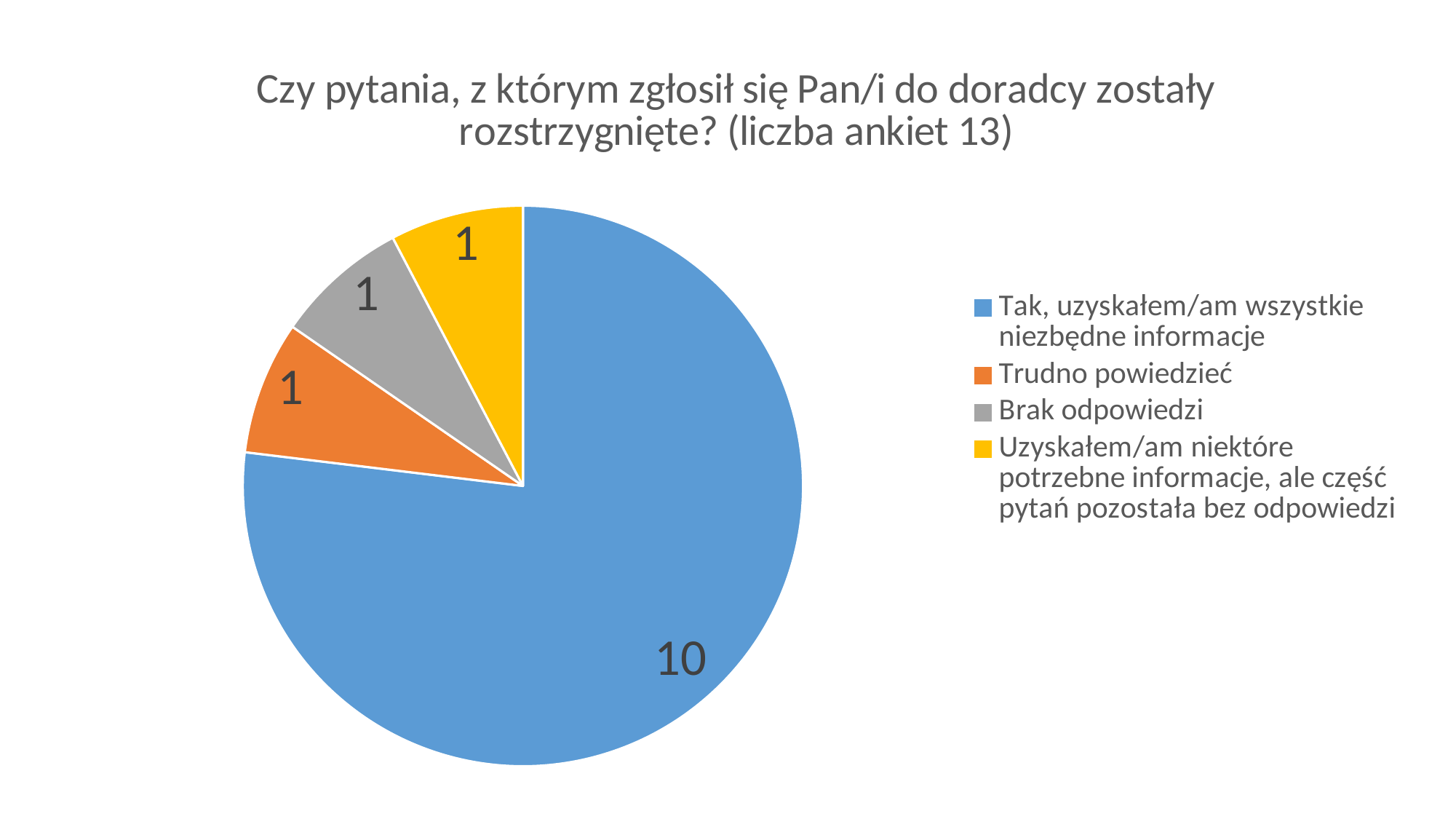
What type of chart is shown on the slide? Pie chart What is the value for "Trudno powiedzieć"? 1 What is the value for "Tak, uzyskałem/am wszystkie niezbędne informacje"? 10 What is the difference between the value for "Tak, uzyskałem/am wszystkie niezbędne informacje" and the value for "Brak odpowiedzi"? 9 What is the value for "Uzyskałem/am niektóre potrzebne informacje, ale część pytań pozostała bez odpowiedzi"? 1 Which is larger: the value for "Tak, uzyskałem/am wszystkie niezbędne informacje" or the value for "Trudno powiedzieć"? Tak, uzyskałem/am wszystkie niezbędne informacje How many entries does the legend list? 4 What colour is the slice for "Brak odpowiedzi"? Grey What is the total of all slices in the pie chart? 13 Which category has the largest slice of the pie? Tak, uzyskałem/am wszystkie niezbędne informacje How many slices does the pie chart have? 4 What is the value for "Brak odpowiedzi"? 1